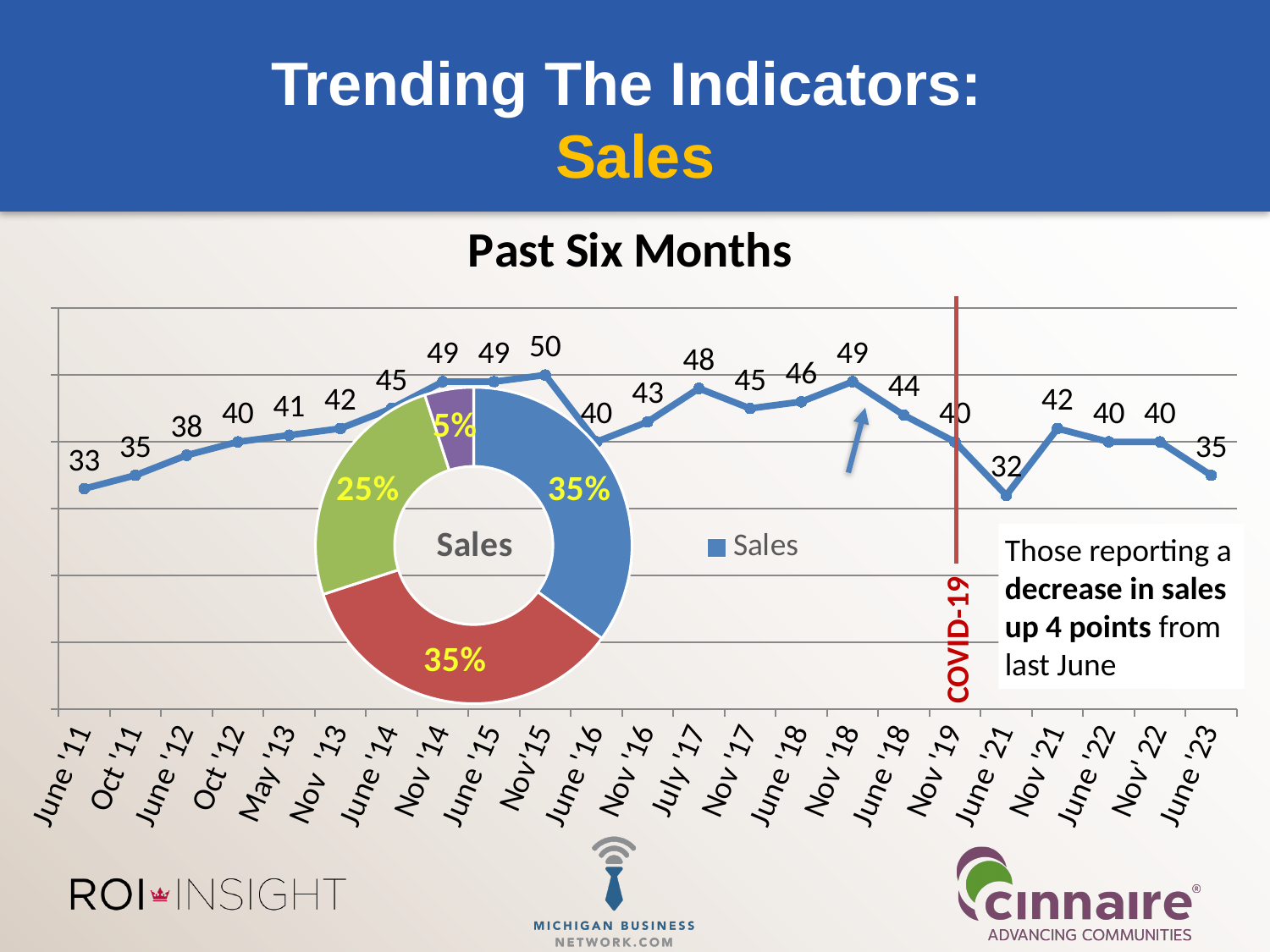
How many slices does the 'Sales' donut chart have? 4 In the 'Past Six Months' line chart, what is the value for June '23? 35 In the 'Sales' donut chart, what is the share of the smallest slice? 5% In the 'Past Six Months' line chart, which is larger, the value for July '17 or the value for Nov '17? July '17 In the 'Past Six Months' line chart, what is the value for Nov '15? 50 In the 'Past Six Months' line chart, what is the value for June '11? 33 In the 'Past Six Months' line chart, do the values rise or fall from June '11 to Nov '15? rise What kind of chart is the 'Past Six Months' chart? line chart In the 'Past Six Months' line chart, which date has the highest value? Nov '15 In the 'Past Six Months' line chart, what is the difference between the values for Nov '15 and June '16? 10 In the 'Past Six Months' line chart, which date has the lowest value? June '21 In the 'Past Six Months' line chart, what is the difference between the values for Nov '22 and June '23? 5